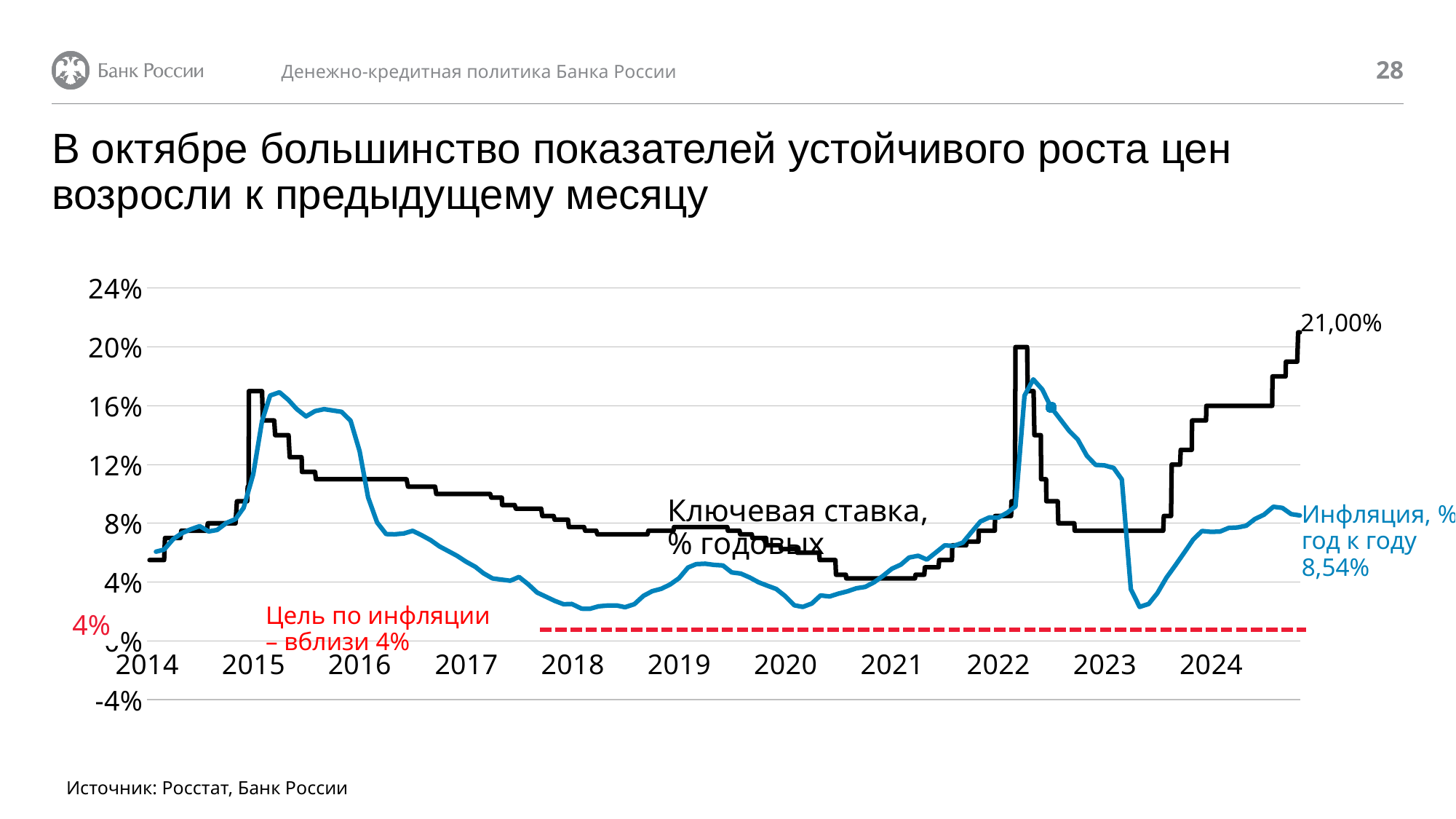
What does the red dashed line on the chart represent? Цель по инфляции – вблизи 4% How many data series are plotted as lines on the chart (excluding the dashed target line)? 2 How many year labels are shown on the x axis? 11 What is the highest value shown on the y axis? 24% What is the difference between the latest key rate value (21,00%) and the latest inflation value (8,54%)? 12,46% Does the key rate rise or fall from mid-2023 to the end of 2024? rises What is the latest value of inflation (Инфляция, % год к году) shown on the chart? 8,54% What is the latest value of the key rate (Ключевая ставка) shown on the chart? 21,00% Is the inflation value in 2018 greater or less than 4%? less At the end of the chart, which is higher: the key rate or inflation? Key rate (Ключевая ставка) What kind of chart is shown on the slide? Line chart Is the peak of the key rate in early 2022 greater or less than 16%? greater